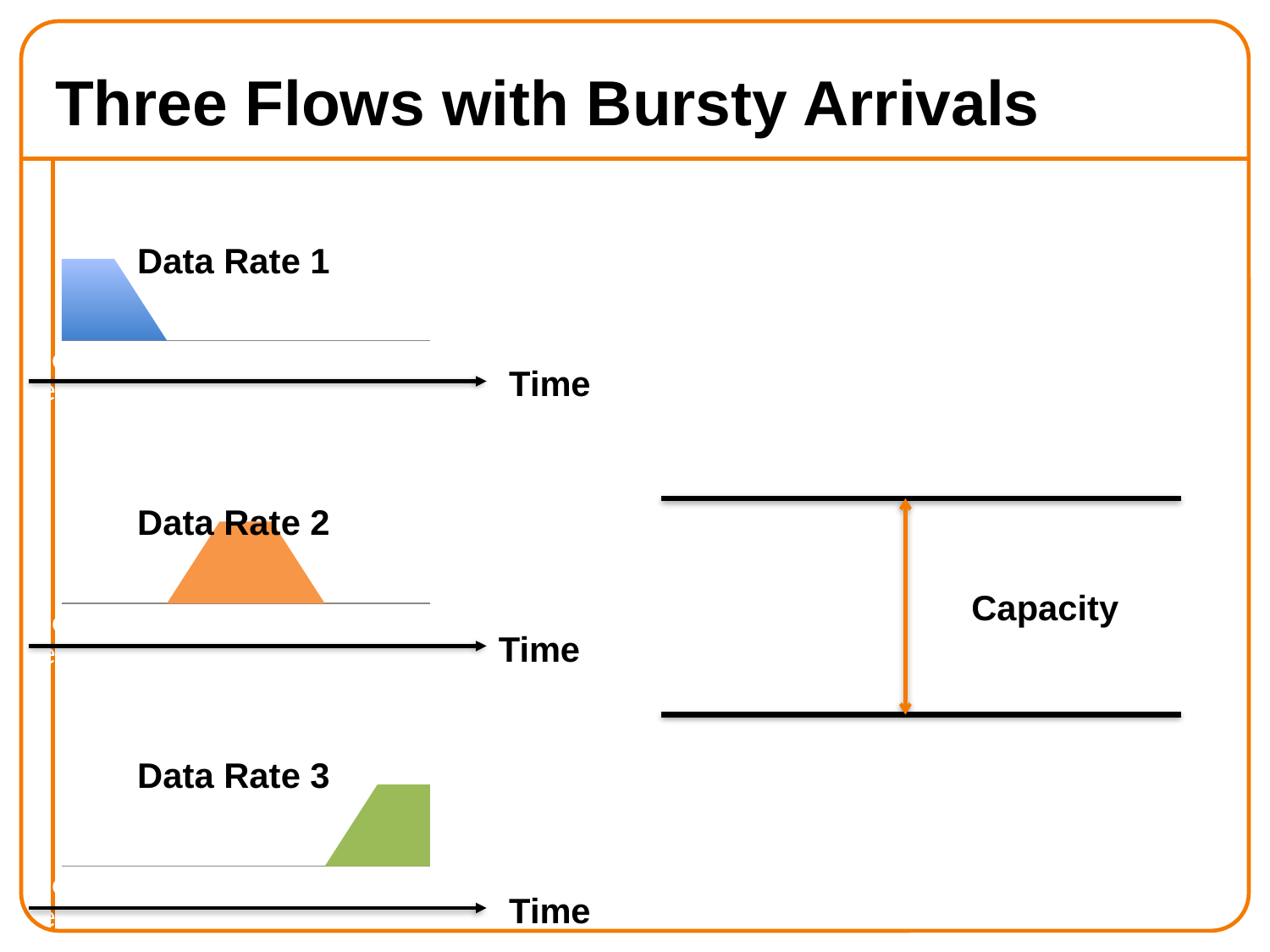
What colour is the shaded area in the Data Rate 2 chart? orange In the Data Rate 2 chart, does the data rate rise then fall, or fall then rise, over time? rise then fall In the Data Rate 1 chart, does the data rate rise or fall as time increases? fall In the Data Rate 3 chart, does the data rate rise or fall as time increases? rise Which data-rate chart shows its burst earliest in time? Data Rate 1 What is the label on the horizontal axis of each data-rate chart? Time Which data-rate chart shows its burst latest in time? Data Rate 3 How many data-rate charts are shown on the slide? 3 What kind of chart is used to show Data Rate 1? area chart